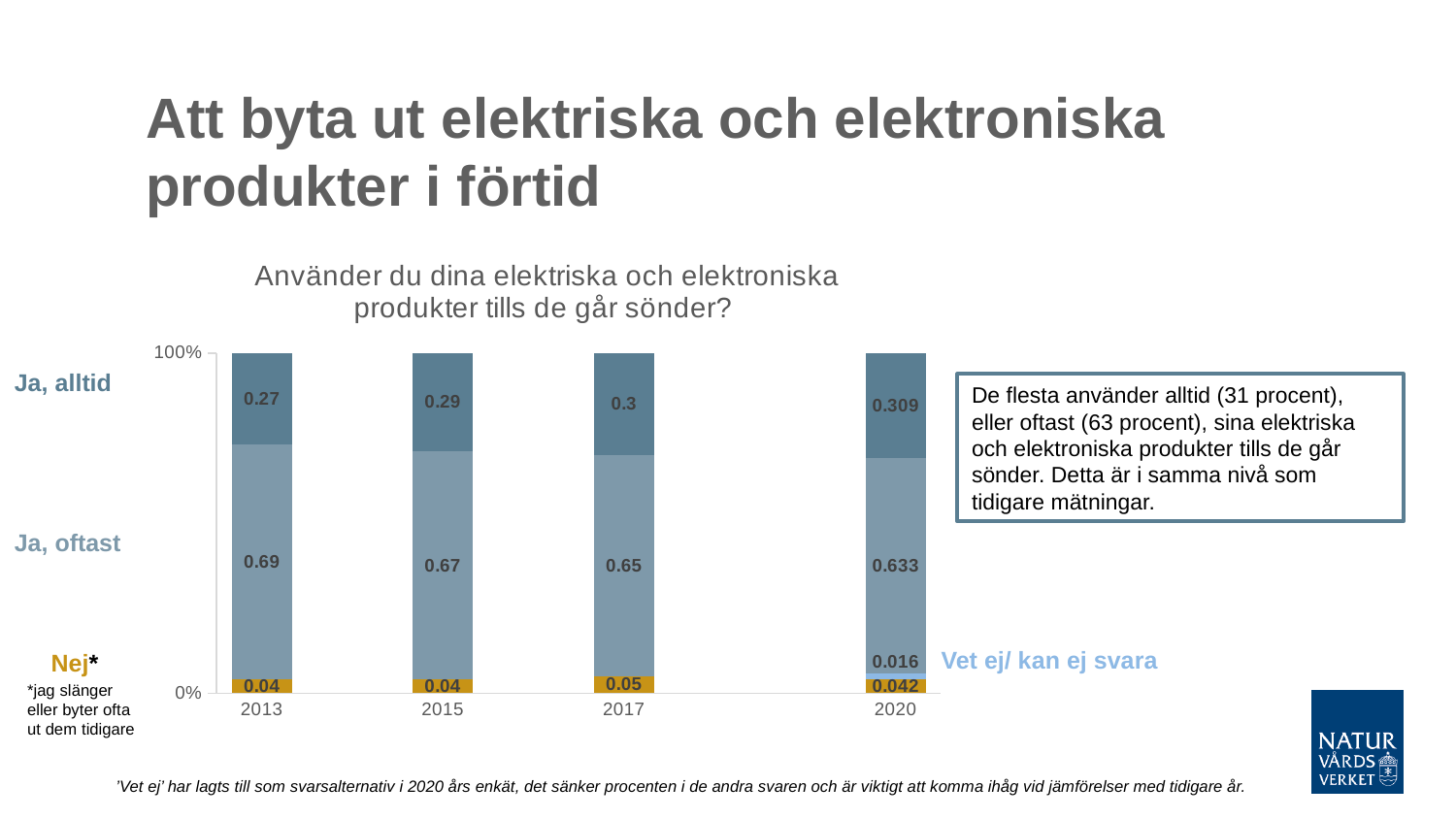
How many years are shown on the x axis? 4 Do the values for 'Ja, alltid' rise or fall from 2013 to 2020? Rise What is the value for 'Nej' in 2017? 0.05 What is the value for 'Vet ej/ kan ej svara' in 2020? 0.016 What is the value for 'Ja, alltid' in 2013? 0.27 What is the title of the chart? Använder du dina elektriska och elektroniska produkter tills de går sönder? In which year is the value for 'Ja, alltid' lowest? 2013 What is the value for 'Ja, oftast' in 2020? 0.633 What kind of chart is shown on the slide? Stacked bar chart Which is larger in 2015: 'Ja, alltid' or 'Ja, oftast'? Ja, oftast In which year is the value for 'Ja, oftast' highest? 2013 What is the difference between the 'Ja, oftast' values in 2013 and 2017? 0.04